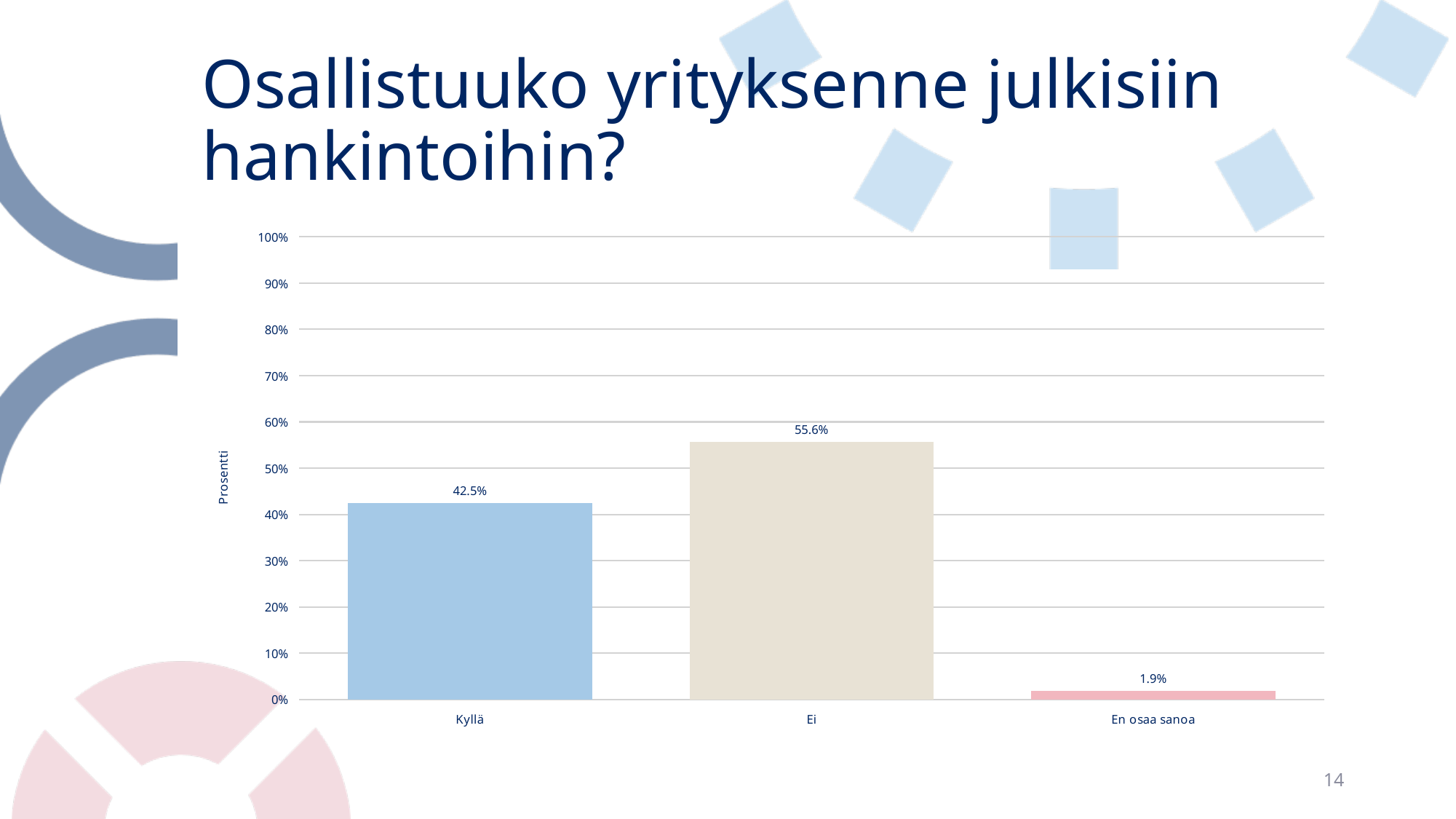
Is the value for Kyllä greater or less than 50%? less What is the title of the slide above the chart? Osallistuuko yrityksenne julkisiin hankintoihin? What is the value for Kyllä? 42.5% Which category has the lowest value? En osaa sanoa How many categories are shown on the x axis? 3 What is the value for En osaa sanoa? 1.9% What kind of chart is shown on the slide? bar chart What is the difference between the values for Ei and Kyllä? 13.1% What is the label of the y axis? Prosentti Which category has the highest value? Ei What is the value for Ei? 55.6% Which is larger, the value for Kyllä or the value for Ei? Ei